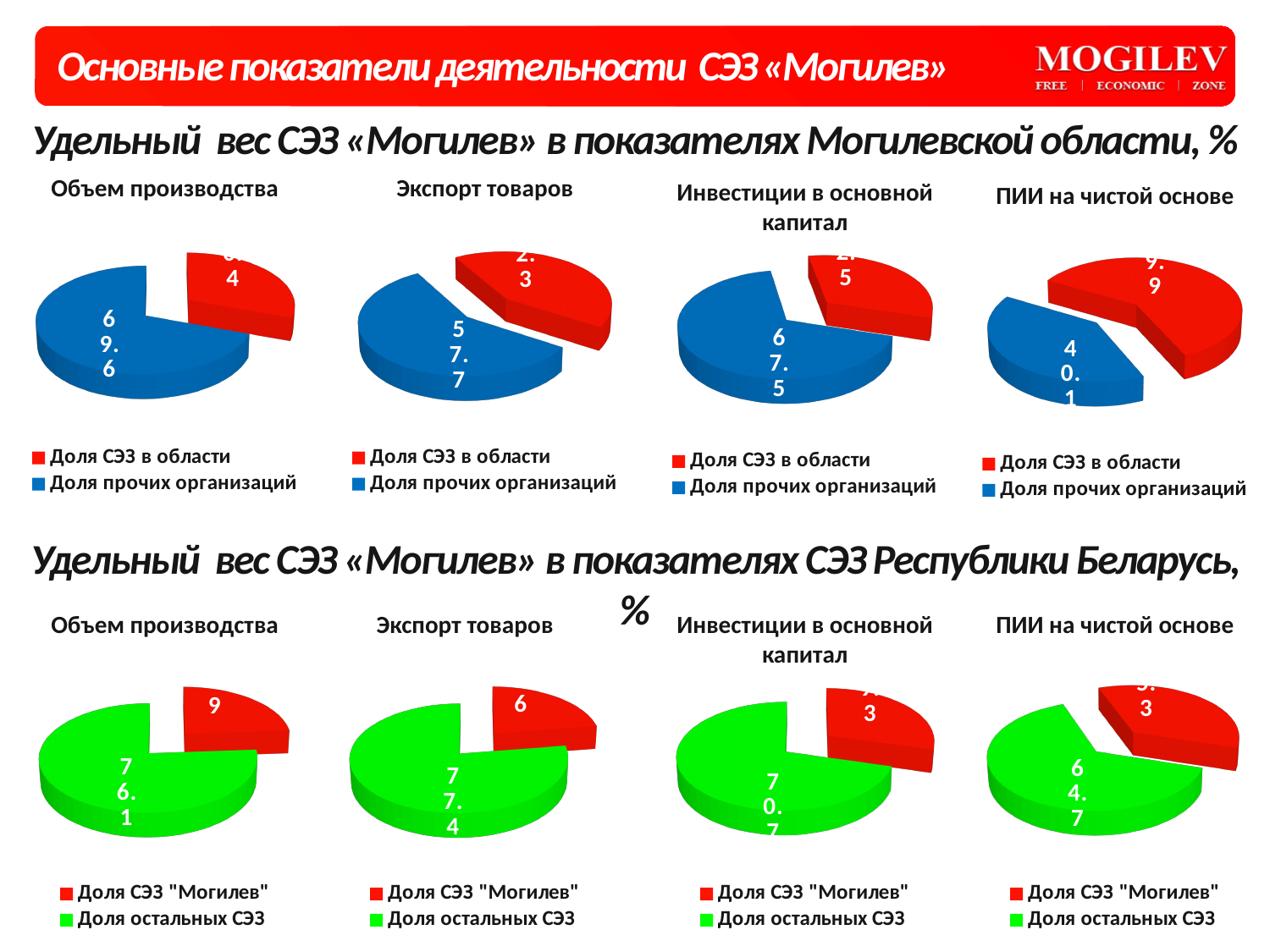
In the bottom-row 'ПИИ на чистой основе' pie chart, what value is shown for 'Доля остальных СЭЗ'? 64.7 In the top-row 'Объем производства' pie chart, what value is shown for 'Доля прочих организаций'? 69.6 In the bottom-row 'Экспорт товаров' pie chart, which slice is larger: 'Доля СЭЗ "Могилев"' or 'Доля остальных СЭЗ'? Доля остальных СЭЗ In the top-row 'Экспорт товаров' pie chart, what value is shown for 'Доля прочих организаций'? 57.7 In the top-row 'ПИИ на чистой основе' pie chart, which slice is larger: 'Доля СЭЗ в области' or 'Доля прочих организаций'? Доля СЭЗ в области What type of chart is used for 'Объем производства' in the top row? Pie chart In the bottom-row 'Объем производства' pie chart, what value is shown for 'Доля остальных СЭЗ'? 76.1 In the top-row 'ПИИ на чистой основе' pie chart, what value is shown for 'Доля прочих организаций'? 40.1 In the bottom-row 'Экспорт товаров' pie chart, what value is shown for 'Доля остальных СЭЗ'? 77.4 How many pie charts are shown on the slide in total? 8 In the top-row 'Инвестиции в основной капитал' pie chart, what value is shown for 'Доля прочих организаций'? 67.5 In the bottom-row 'Инвестиции в основной капитал' pie chart, what value is shown for 'Доля остальных СЭЗ'? 70.7